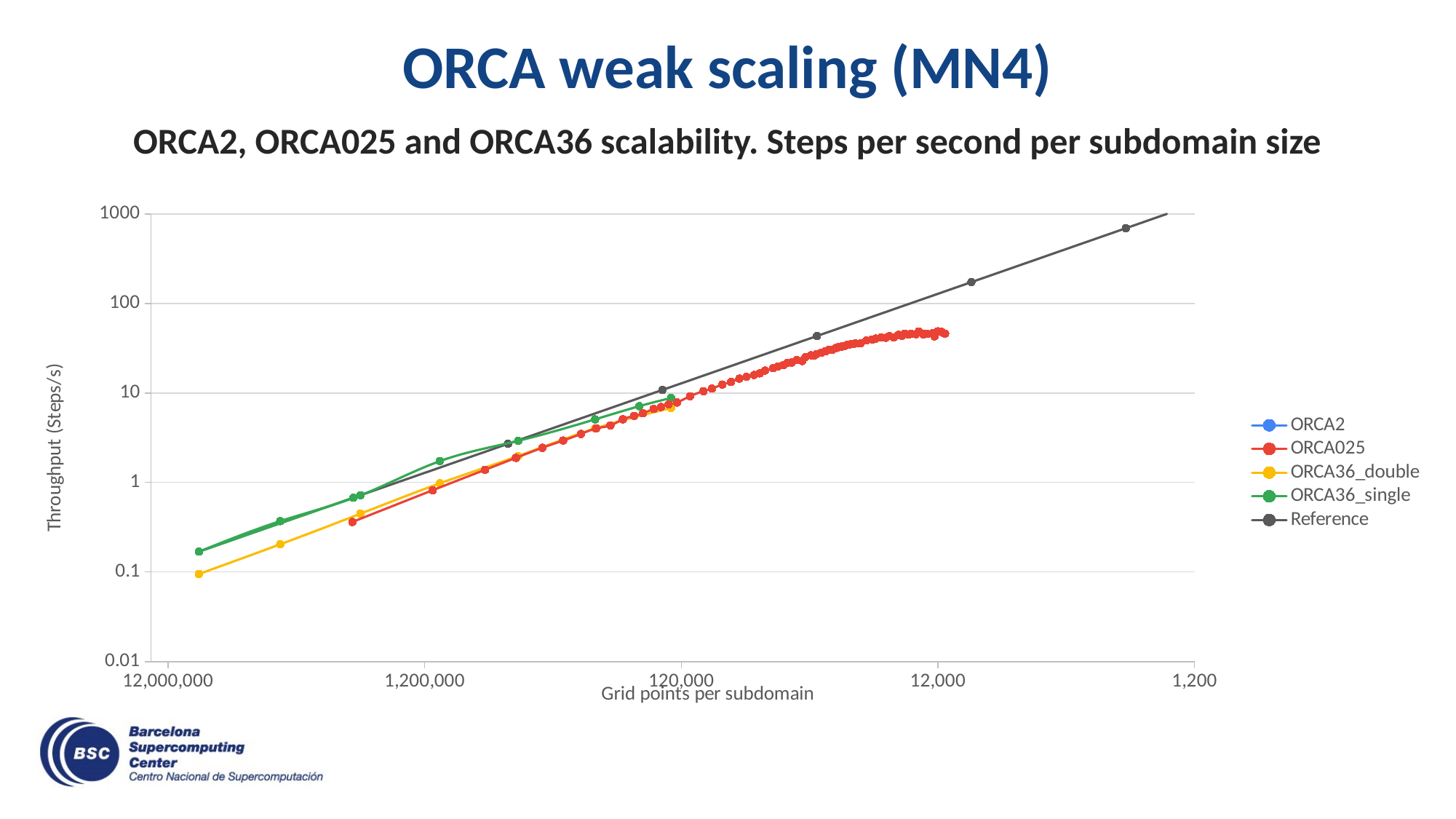
Is the throughput of ORCA36_single at its leftmost point greater or less than 0.1 Steps/s? greater Which series reaches the highest throughput on the chart? Reference What kind of chart is shown on the slide? line chart Is the throughput of the Reference series at 12,000 grid points per subdomain greater or less than 100 Steps/s? greater Which series has the lowest throughput at the leftmost point of the chart? ORCA36_double At the leftmost point (around 12,000,000 grid points per subdomain), which series has the higher throughput, ORCA36_single or ORCA36_double? ORCA36_single What is the title of the chart? ORCA2, ORCA025 and ORCA36 scalability. Steps per second per subdomain size What is the label of the y axis? Throughput (Steps/s) Is the highest throughput reached by the ORCA025 series greater or less than 100 Steps/s? less Do the throughput values rise or fall moving from left to right along the x axis? rise How many series does the legend list? 5